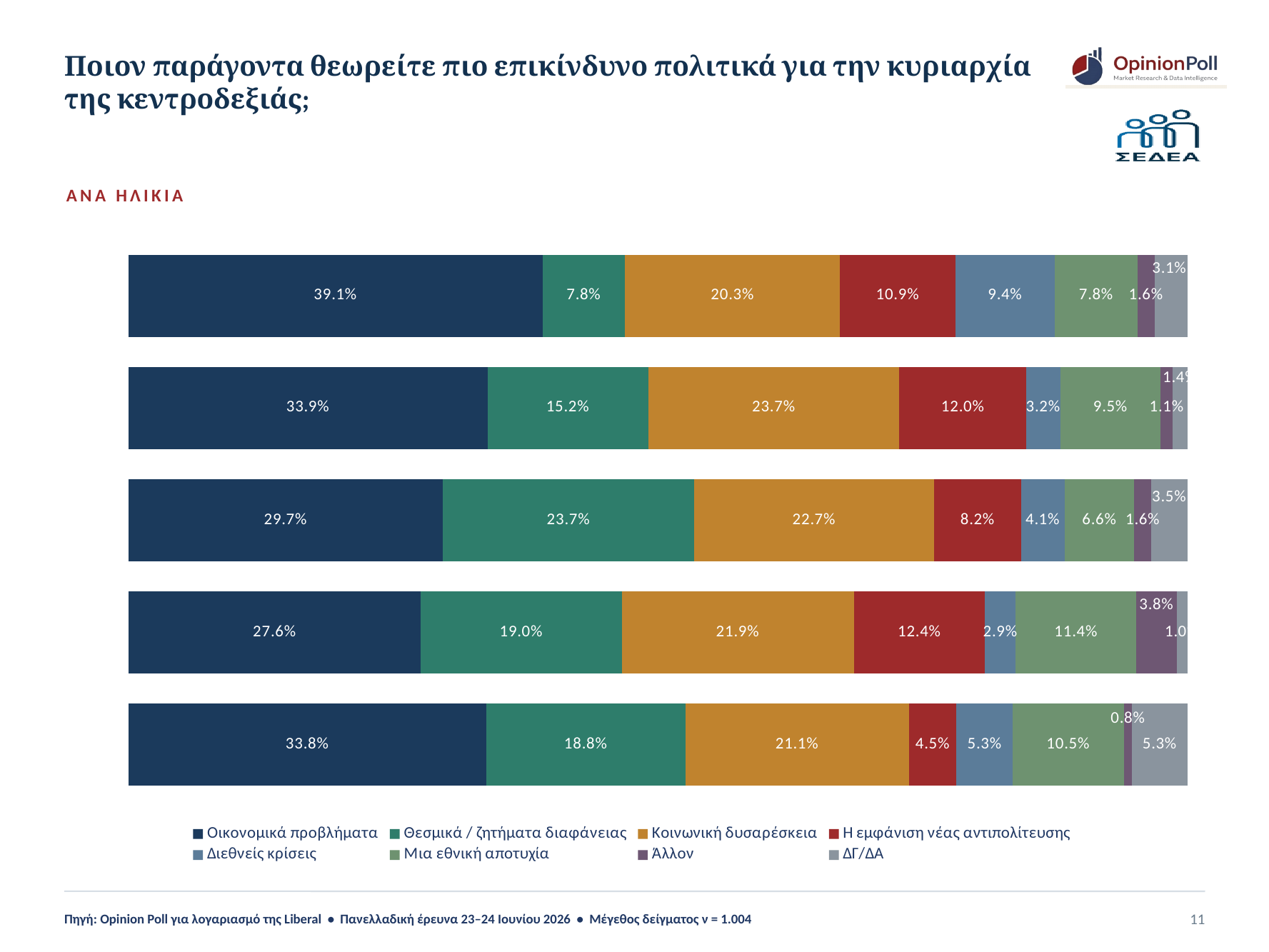
How many bars are plotted in the chart? 5 In the top bar, what is the value for Οικονομικά προβλήματα? 39.1% In the second bar from the top, what is the value for Διεθνείς κρίσεις? 3.2% What kind of chart is shown on the slide? Stacked bar chart In the third bar from the top, which is larger: Θεσμικά / ζητήματα διαφάνειας or Κοινωνική δυσαρέσκεια? Θεσμικά / ζητήματα διαφάνειας Which bar has the highest value for Οικονομικά προβλήματα? The top bar (39.1%) In the bottom bar, what is the value for Μια εθνική αποτυχία? 10.5% Which bar has the lowest value for Οικονομικά προβλήματα? The fourth bar from the top (27.6%) In the top bar, what is the difference between Οικονομικά προβλήματα and Κοινωνική δυσαρέσκεια? 18.8 percentage points In the fourth bar from the top, what is the value for Η εμφάνιση νέας αντιπολίτευσης? 12.4% What colour represents Κοινωνική δυσαρέσκεια in the legend? Orange How many series does the legend list? 8